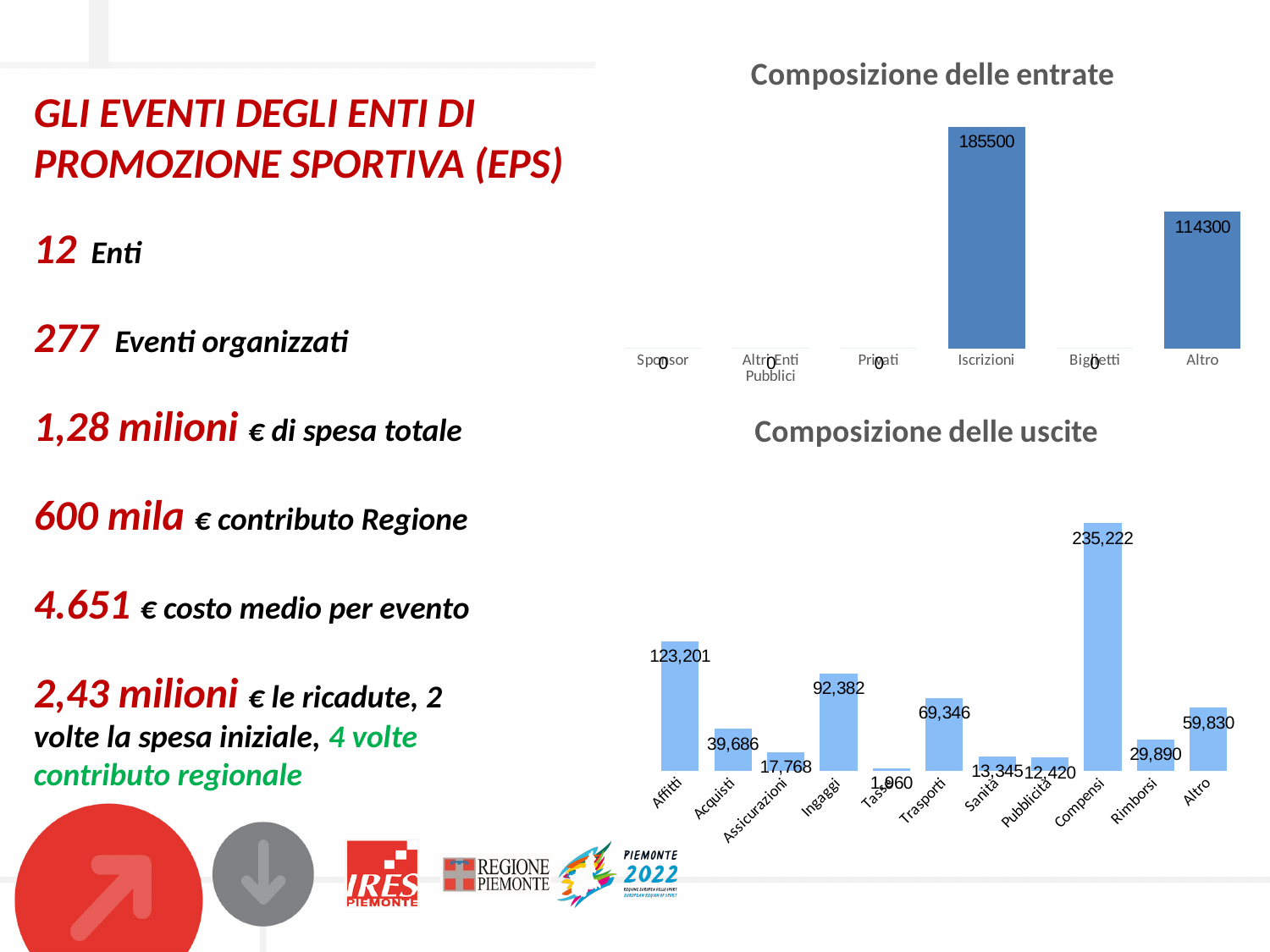
In the 'Composizione delle entrate' chart, which category has the highest value? Iscrizioni In the 'Composizione delle uscite' chart, which category has the lowest value? Tasse How many categories are shown in the 'Composizione delle entrate' chart? 6 In the 'Composizione delle uscite' chart, what is the value for Compensi? 235,222 In the 'Composizione delle entrate' chart, what is the value for Iscrizioni? 185500 In the 'Composizione delle uscite' chart, which is larger, Affitti or Ingaggi? Affitti What type of chart is 'Composizione delle uscite'? Bar chart How many categories are shown in the 'Composizione delle uscite' chart? 11 In the 'Composizione delle uscite' chart, what is the difference between Acquisti and Rimborsi? 9,796 In the 'Composizione delle entrate' chart, what is the difference between Iscrizioni and Altro? 71200 In the 'Composizione delle uscite' chart, what is the value for Trasporti? 69,346 In the 'Composizione delle entrate' chart, what is the value for Altro? 114300